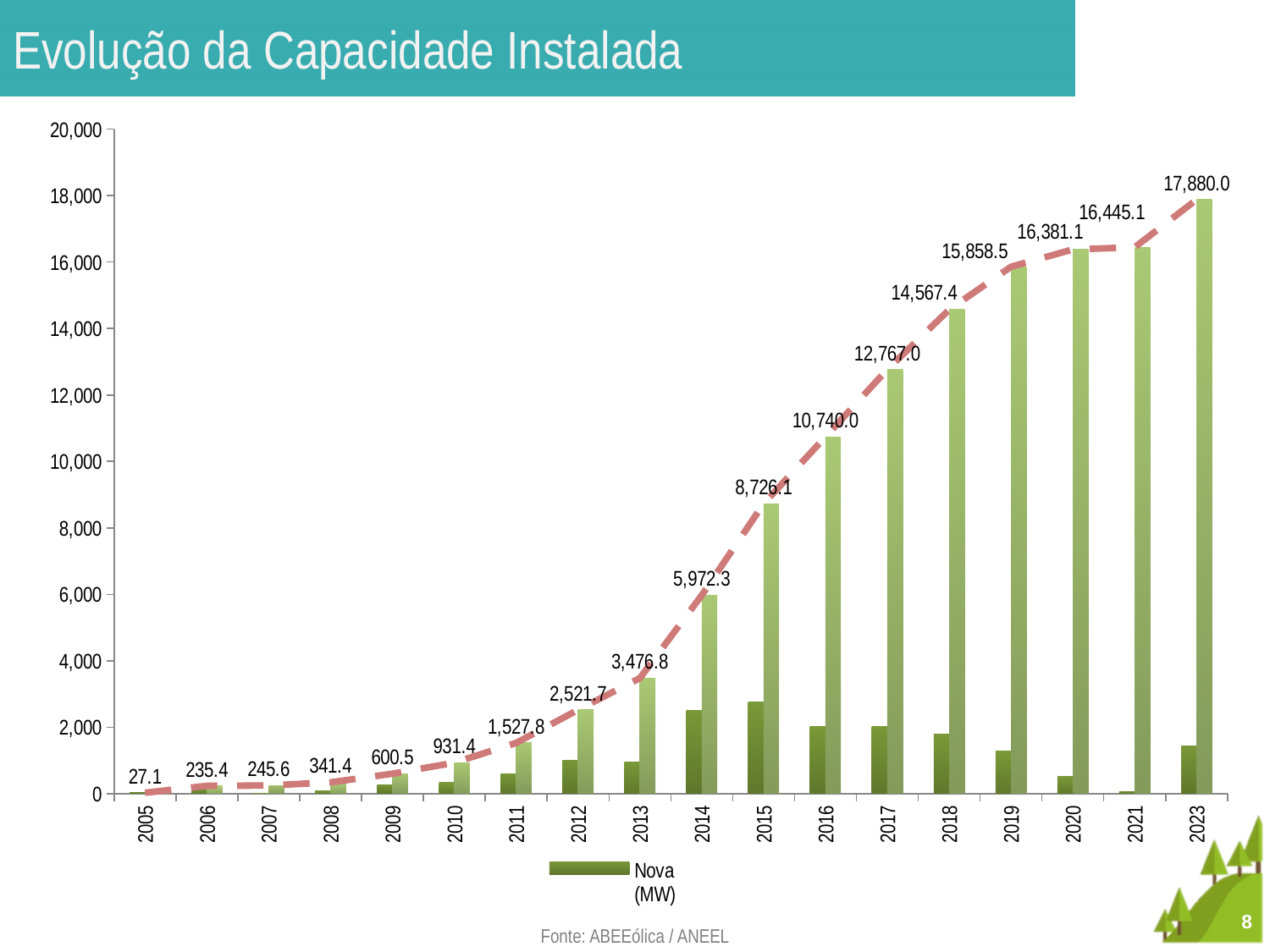
What is the labeled value for 2005? 27.1 Which year has the lowest labeled value? 2005 What is the difference between the labeled values for 2014 and 2013? 2,495.5 Which year has the highest labeled value? 2023 What is the difference between the labeled values for 2023 and 2021? 1,434.9 What is the labeled value for 2023? 17,880.0 What is the labeled value for 2015? 8,726.1 Which is larger, the labeled value for 2016 or for 2017? 2017 How many years are shown on the x axis? 18 Do the labeled values rise or fall from 2005 to 2023? rise Is the dark green (Nova) bar for 2019 greater or less than 2,000? less What is the labeled value for 2010? 931.4